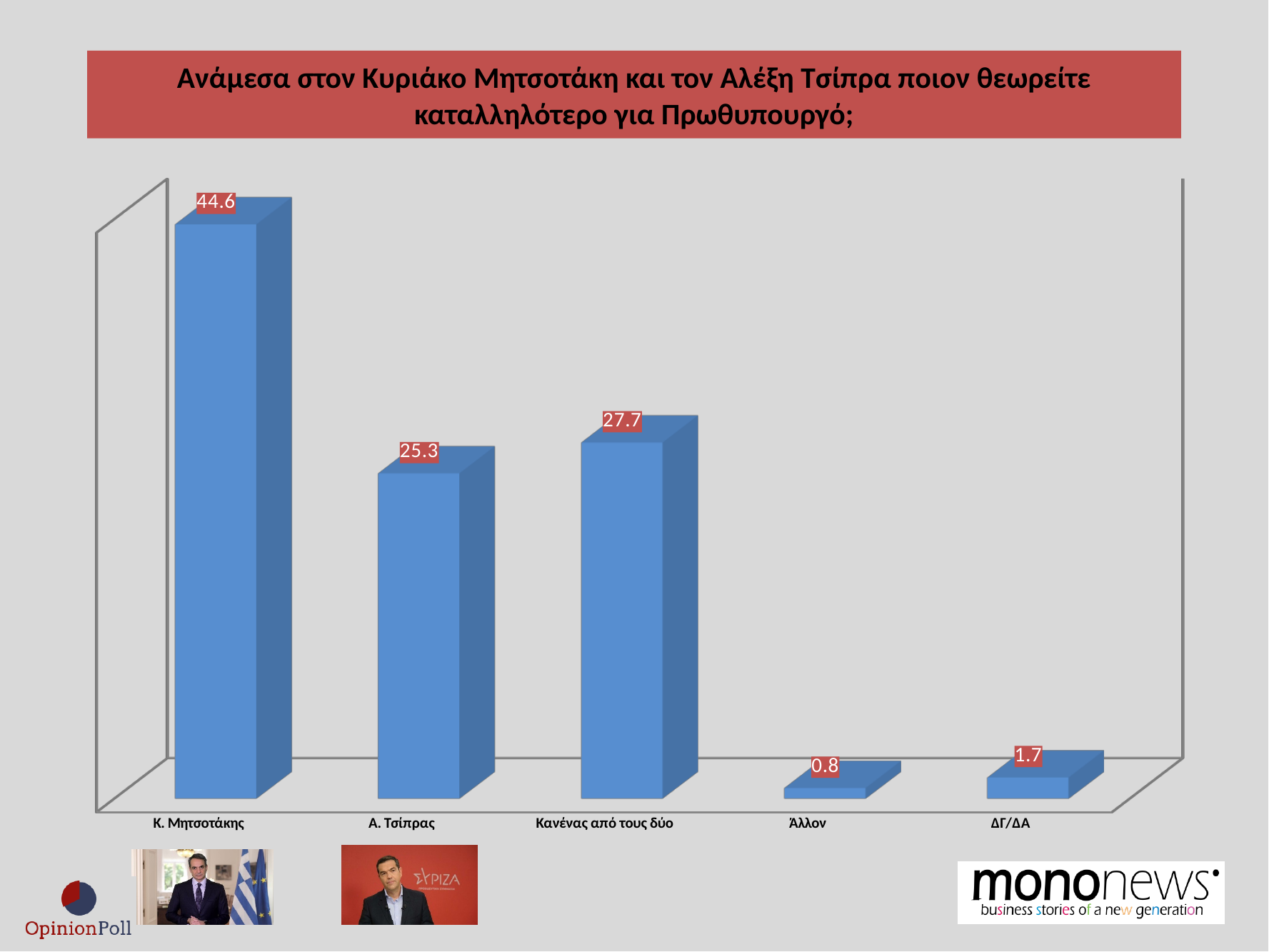
What is the difference between the values for Κ. Μητσοτάκης and Α. Τσίπρας? 19.3 How many categories are shown in the chart? 5 What kind of chart is shown on the slide? Bar chart Which category has the lowest value? Άλλον What is the value for Άλλον? 0.8 What is the difference between the values for ΔΓ/ΔΑ and Άλλον? 0.9 What is the value for Κανένας από τους δύο? 27.7 Which is larger, the value for Α. Τσίπρας or the value for Κανένας από τους δύο? Κανένας από τους δύο What is the value for ΔΓ/ΔΑ? 1.7 Which category has the highest value? Κ. Μητσοτάκης What is the value for Α. Τσίπρας? 25.3 What is the value for Κ. Μητσοτάκης? 44.6